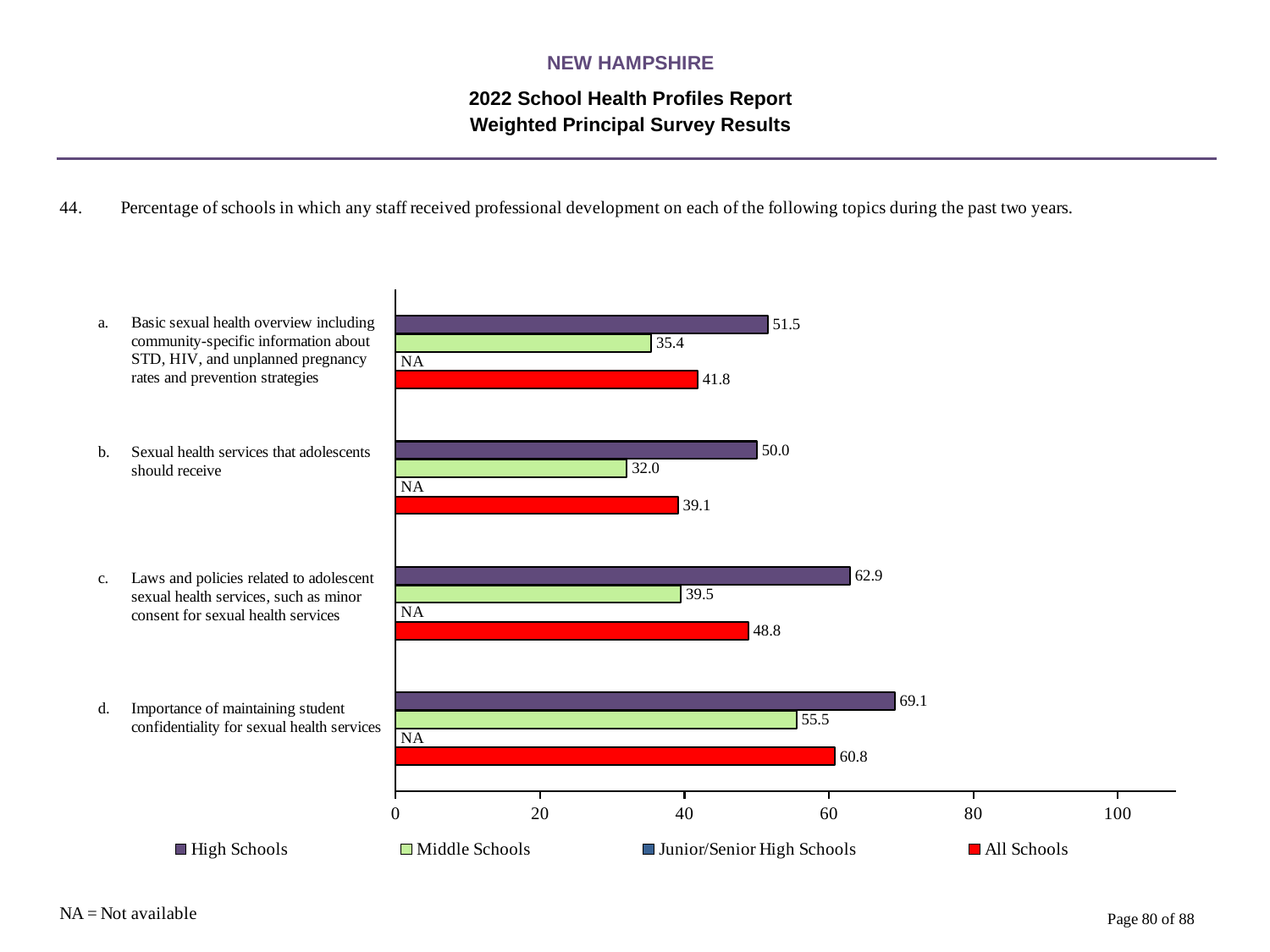
What is the Middle Schools value for topic b, sexual health services that adolescents should receive? 32.0 Which topic has the highest All Schools value? d. Importance of maintaining student confidentiality for sexual health services What is the High Schools value for topic d, importance of maintaining student confidentiality for sexual health services? 69.1 Which topic has the lowest Middle Schools value? b. Sexual health services that adolescents should receive What is the difference between the High Schools and Middle Schools values for topic c, laws and policies related to adolescent sexual health services? 23.4 How many topics are listed on the chart? 4 What does NA stand for according to the note on the slide? Not available How many series does the legend list? 4 What is shown for Junior/Senior High Schools for topic a, basic sexual health overview? NA What is the All Schools value for topic c, laws and policies related to adolescent sexual health services? 48.8 For topic a, basic sexual health overview, which is larger: the High Schools value or the All Schools value? High Schools What kind of chart is shown on the slide? Bar chart